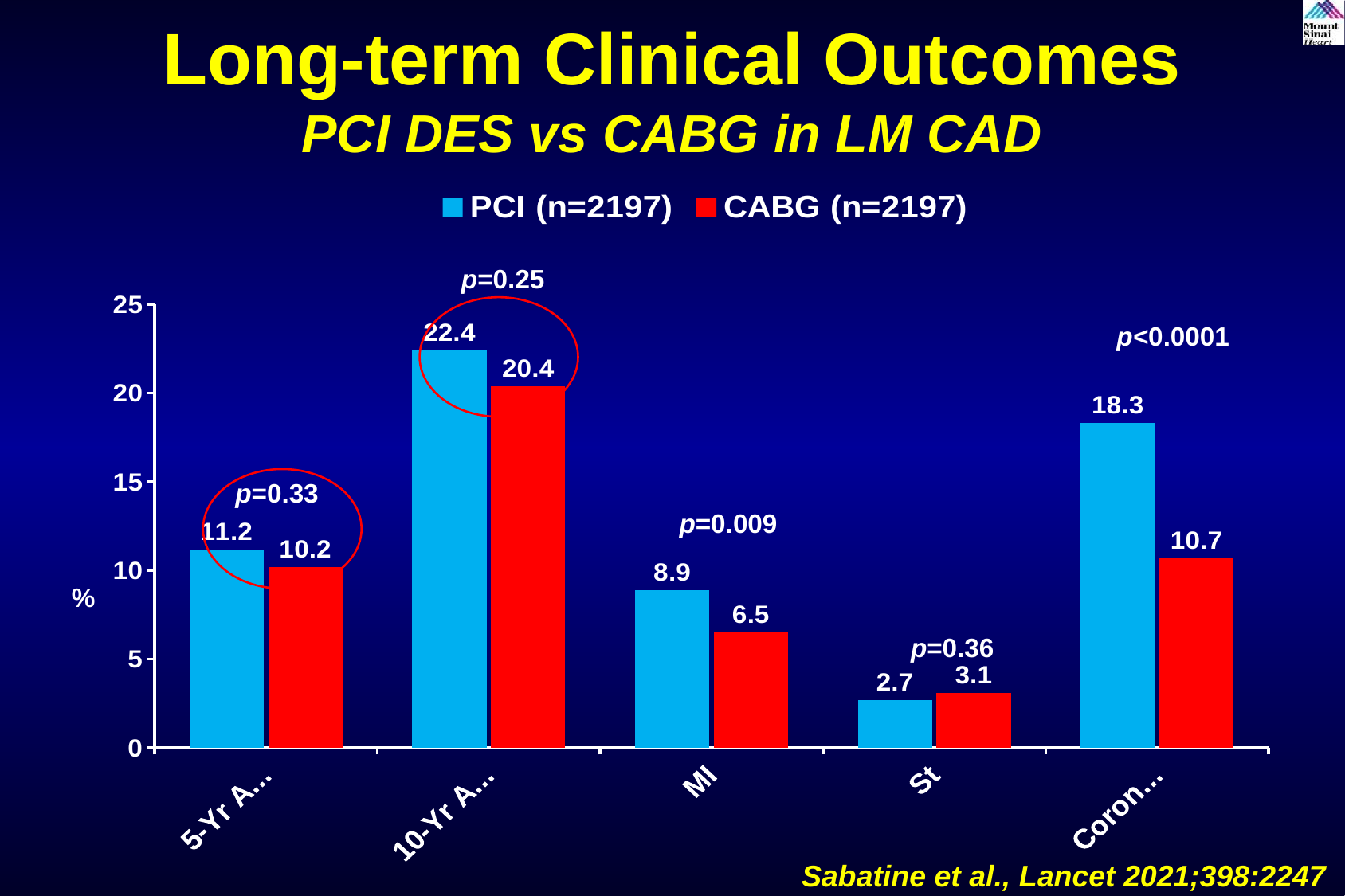
What is the CABG value for MI? 6.5 What is the CABG value for the rightmost category? 10.7 What is the PCI value for St? 2.7 What is the PCI value for the second category from the left (10-Yr)? 22.4 Which category has the lowest CABG value? St Which category has the highest PCI value? 10-Yr A… (second category) What kind of chart is shown? Bar chart What is the difference between the PCI and CABG values for MI? 2.4 What is the CABG value for St? 3.1 For St, which is larger, the PCI value or the CABG value? CABG What is the PCI value for MI? 8.9 How many series does the legend list? 2